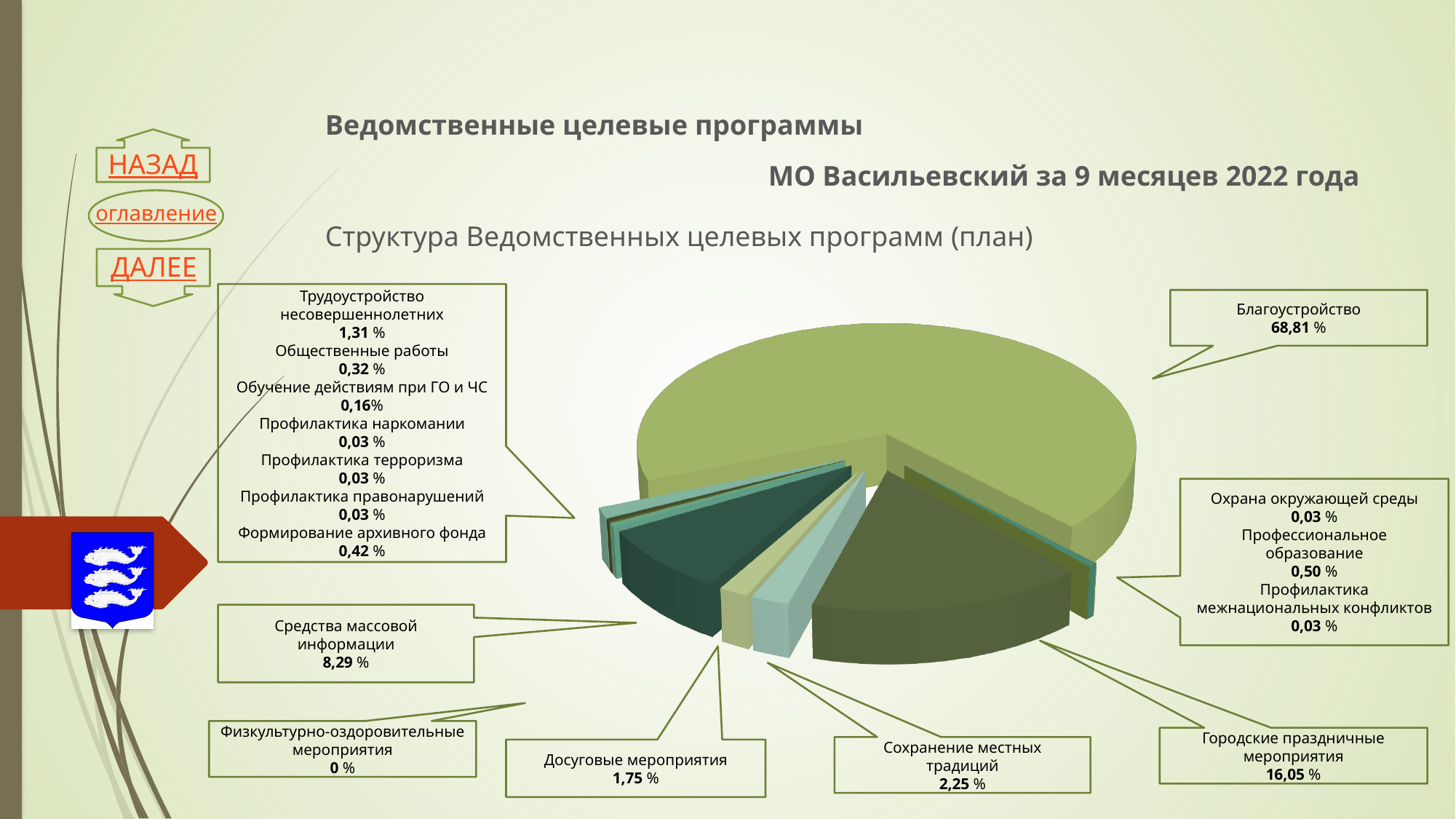
What is the share for Формирование архивного фонда? 0,42 % What is the share for Городские праздничные мероприятия? 16,05 % What type of chart is shown on the slide? Pie chart What is the title of the chart on the slide? Структура Ведомственных целевых программ (план) What is the difference between the shares of Благоустройство and Городские праздничные мероприятия? 52,76 % Which is larger: the share for Средства массовой информации or for Сохранение местных традиций? Средства массовой информации Which category has the smallest share in the pie chart? Физкультурно-оздоровительные мероприятия What is the difference between the shares of Сохранение местных традиций and Досуговые мероприятия? 0,50 % What is the share for Благоустройство in the pie chart? 68,81 % What is the share for Досуговые мероприятия? 1,75 % What is the share for Средства массовой информации? 8,29 % Which category has the largest share in the pie chart? Благоустройство